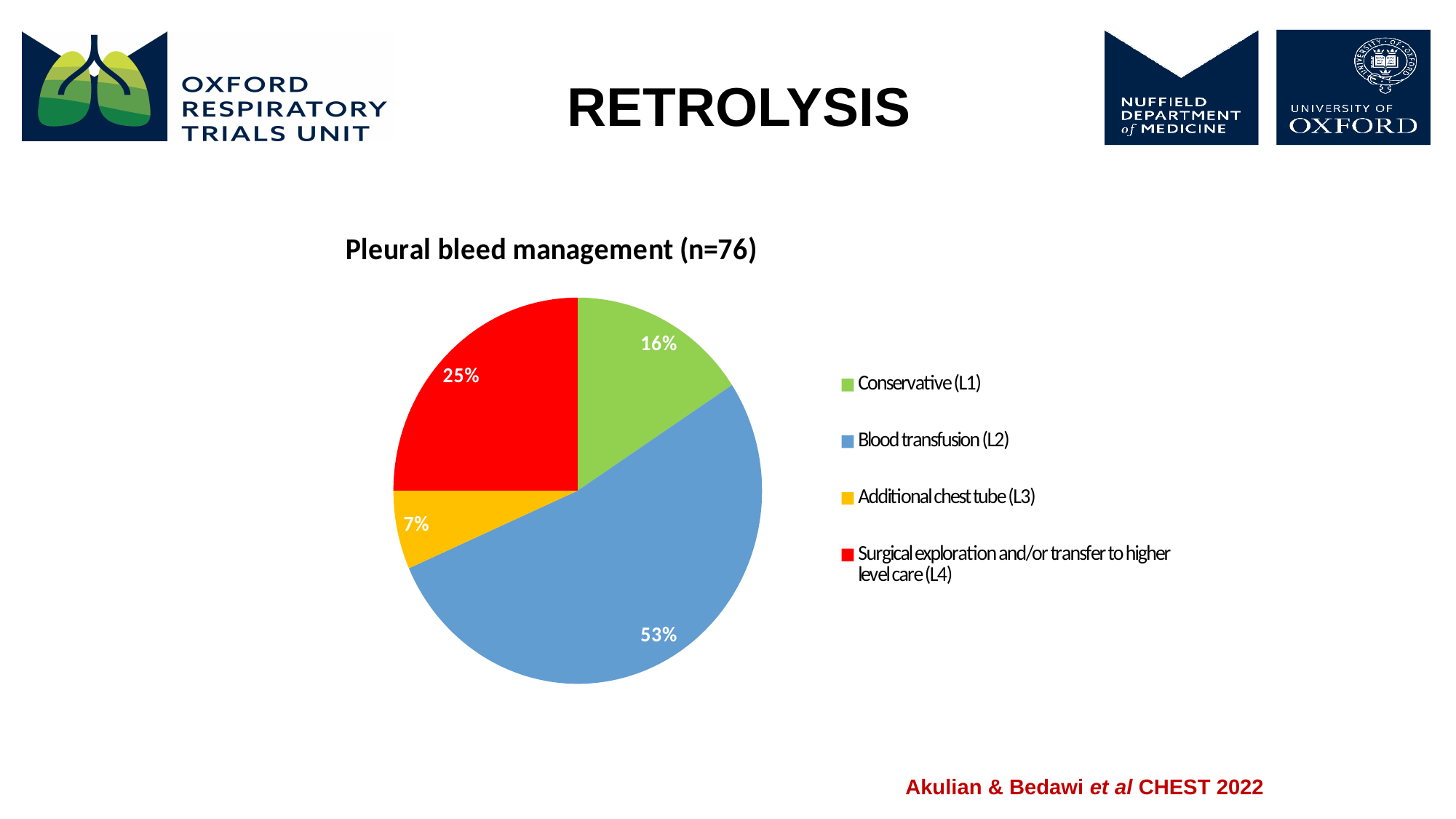
What share of the pie is Blood transfusion (L2)? 53% How many categories does the pie chart show? 4 What colour is the slice for Surgical exploration and/or transfer to higher level care (L4)? Red Which is larger, the share for Conservative (L1) or the share for Additional chest tube (L3)? Conservative (L1) What kind of chart is shown on the slide? Pie chart Which category has the largest slice of the pie? Blood transfusion (L2) Which category has the smallest slice of the pie? Additional chest tube (L3) What is the title of the chart? Pleural bleed management (n=76) What share of the pie is Conservative (L1)? 16% What is the difference in percentage points between Blood transfusion (L2) and Surgical exploration and/or transfer to higher level care (L4)? 28 percentage points What share of the pie is Additional chest tube (L3)? 7%